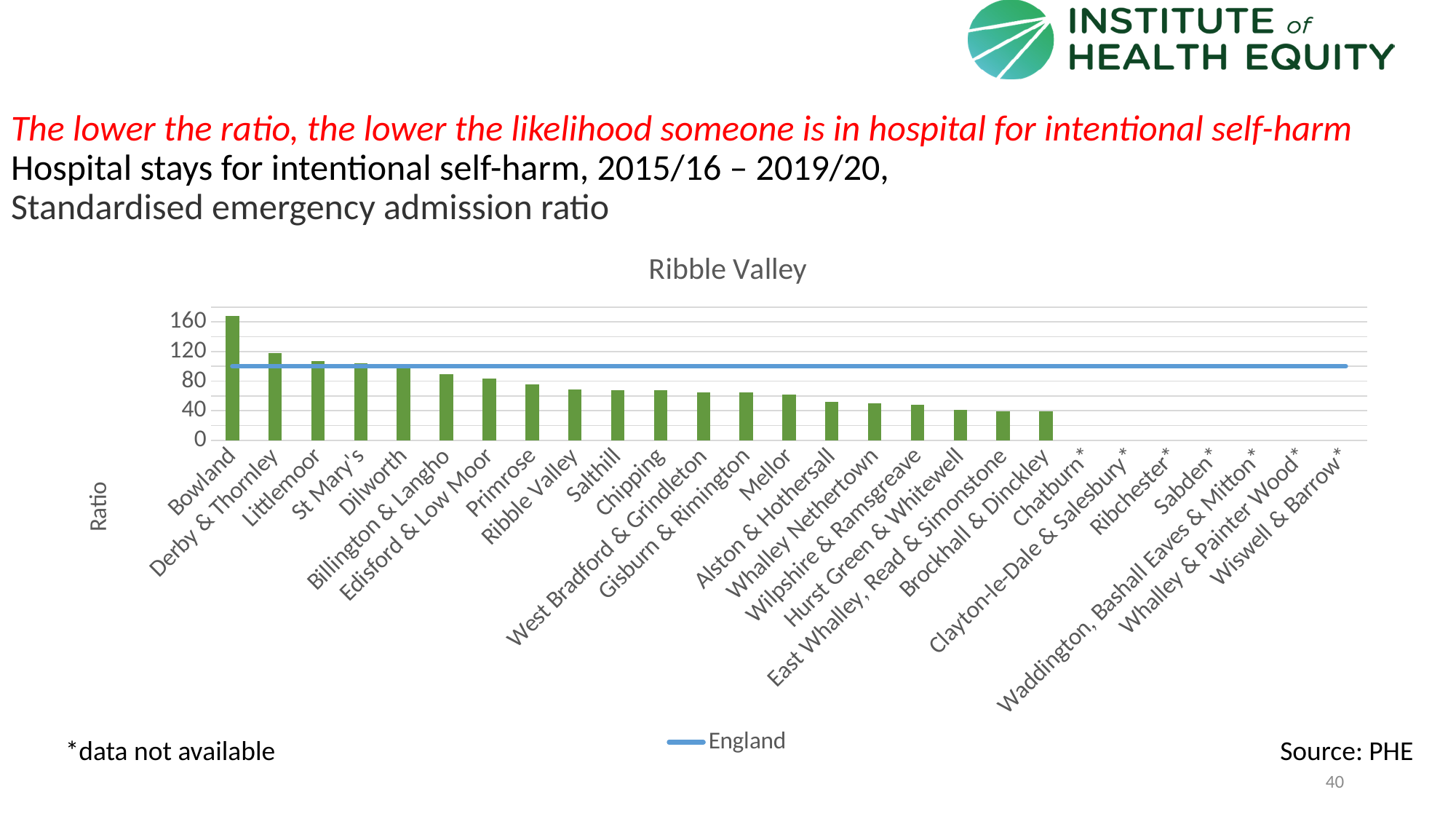
Is the value for Mellor greater or less than 40? greater Is the value for Billington & Langho greater or less than 120? less Which area has the highest ratio in the chart? Bowland Which has the larger ratio, Bowland or Derby & Thornley? Bowland Do the bar values rise or fall from left to right along the x axis? Fall How many areas are marked with an asterisk as having no data available? 7 Which has the larger ratio, Chipping or Hurst Green & Whitewell? Chipping Is the value for Primrose greater or less than 80? less What is the title of the chart? Ribble Valley What type of chart is shown on the slide? Combination bar and line chart (bars with a line for England)